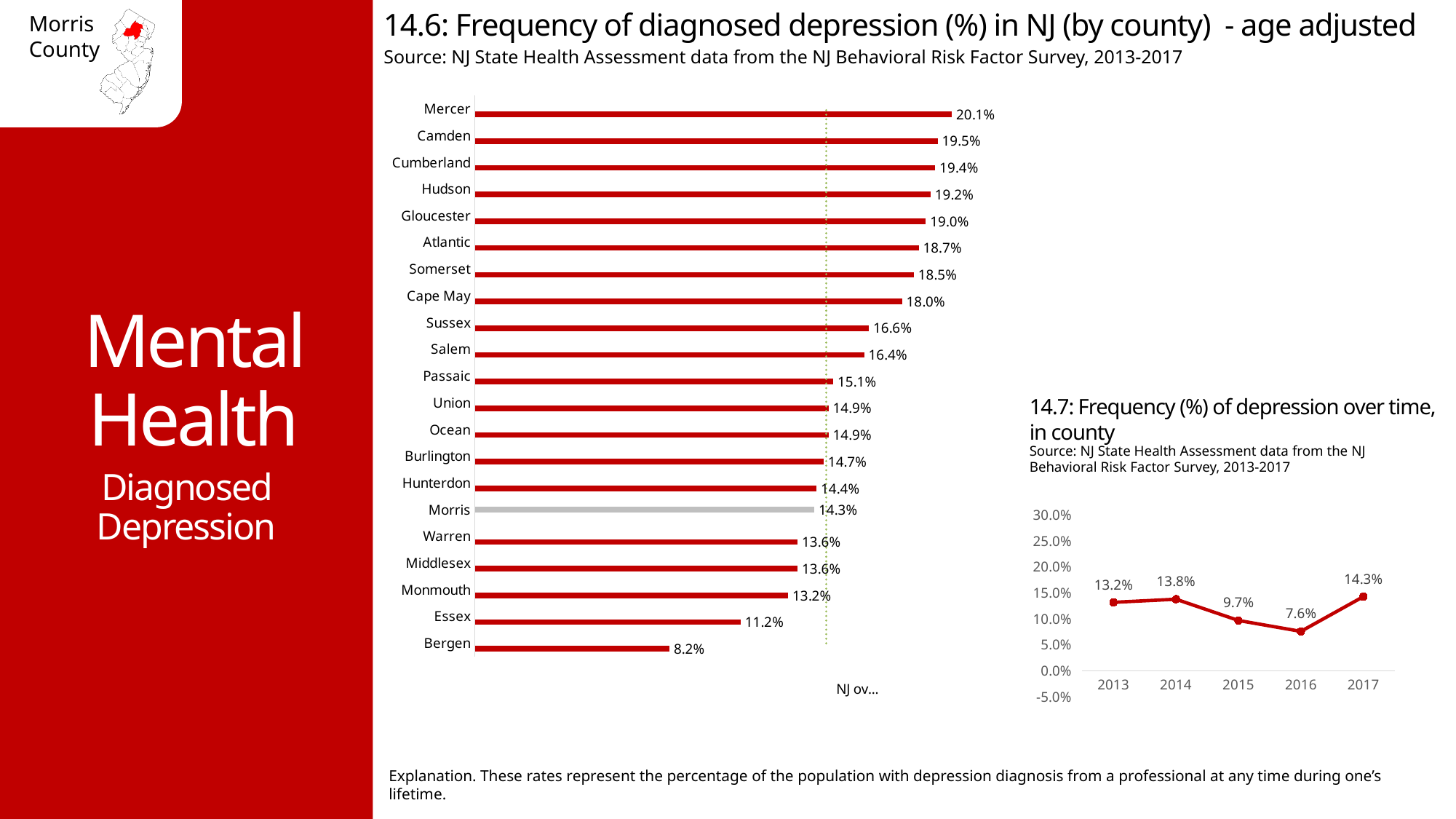
In chart 14.6 (frequency of diagnosed depression by county), which county has the highest value? Mercer In chart 14.6 (frequency of diagnosed depression by county), what is the difference between Mercer and Bergen? 11.9% In chart 14.7 (frequency of depression over time in county), what is the difference between 2014 and 2015? 4.1% In chart 14.7 (frequency of depression over time in county), how many years are plotted? 5 In chart 14.7 (frequency of depression over time in county), what is the value for 2016? 7.6% In chart 14.6 (frequency of diagnosed depression by county), what is the value for Essex? 11.2% In chart 14.6 (frequency of diagnosed depression by county), what is the value for Morris? 14.3% In chart 14.7 (frequency of depression over time in county), which year has the highest value? 2017 In chart 14.6 (frequency of diagnosed depression by county), how many counties are shown? 21 What kind of chart is chart 14.6 (frequency of diagnosed depression by county)? Bar chart In chart 14.6 (frequency of diagnosed depression by county), which county has the lowest value? Bergen In chart 14.6 (frequency of diagnosed depression by county), which is larger, Sussex or Salem? Sussex